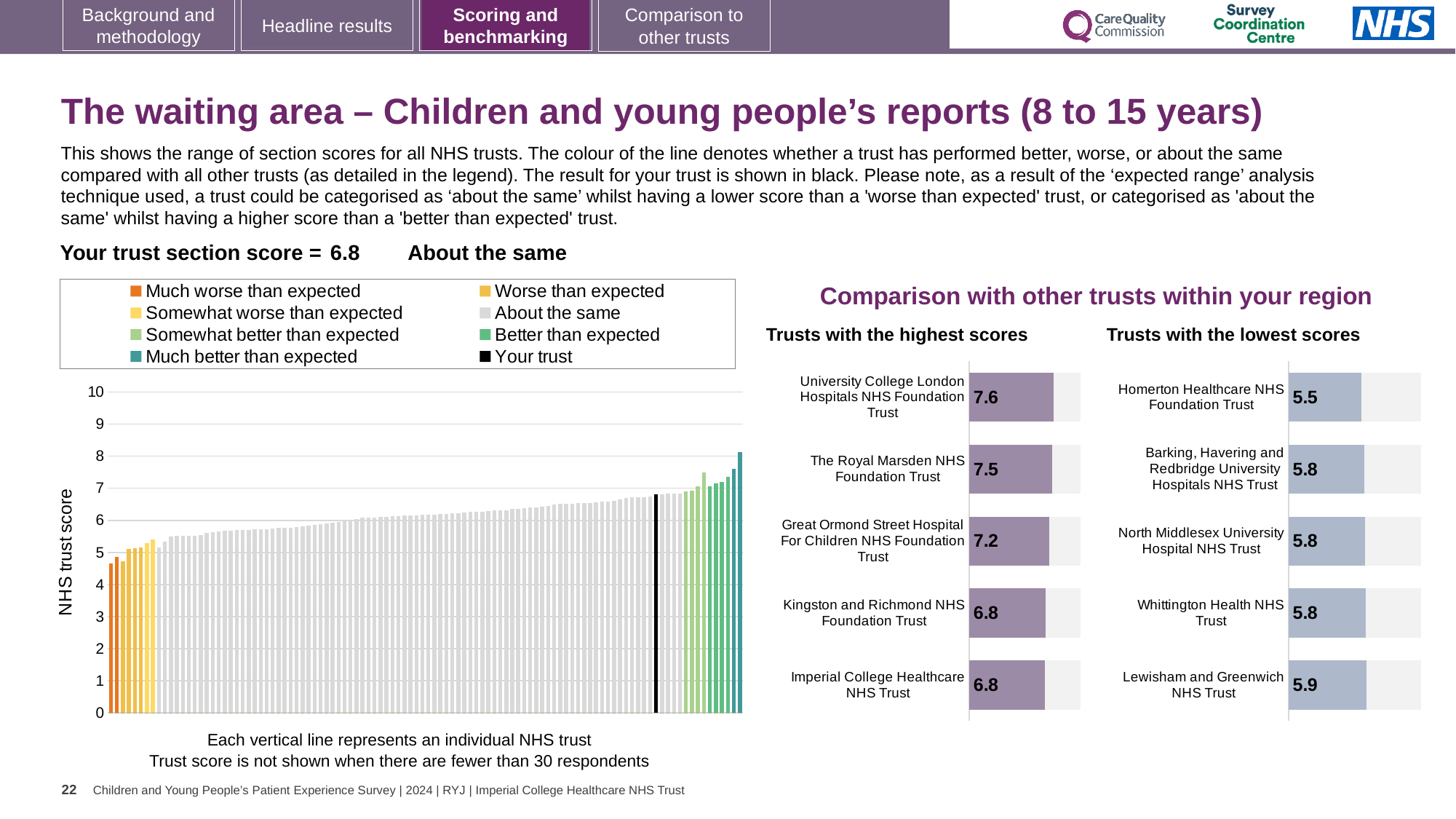
In the 'Trusts with the lowest scores' chart, what is the difference between the scores of Lewisham and Greenwich NHS Trust and Homerton Healthcare NHS Foundation Trust? 0.4 In the 'Trusts with the lowest scores' chart, which trust has the lowest score? Homerton Healthcare NHS Foundation Trust In the 'Trusts with the highest scores' chart, which trust has the highest score? University College London Hospitals NHS Foundation Trust In the 'Trusts with the highest scores' chart, what is the score for University College London Hospitals NHS Foundation Trust? 7.6 In the 'Trusts with the highest scores' chart, which has the larger score: The Royal Marsden NHS Foundation Trust or Kingston and Richmond NHS Foundation Trust? The Royal Marsden NHS Foundation Trust In the 'Trusts with the highest scores' chart, what is the score for Great Ormond Street Hospital For Children NHS Foundation Trust? 7.2 In the 'Trusts with the highest scores' chart, what is the difference between the scores of University College London Hospitals NHS Foundation Trust and Great Ormond Street Hospital For Children NHS Foundation Trust? 0.4 What kind of chart is the large chart on the left showing NHS trust scores? Bar chart In the 'Trusts with the lowest scores' chart, what is the score for Lewisham and Greenwich NHS Trust? 5.9 How many entries does the legend of the large chart on the left list? 8 In the large chart on the left, is the value for the black 'Your trust' bar greater or less than 6? greater How many trusts are shown in the 'Trusts with the lowest scores' chart? 5